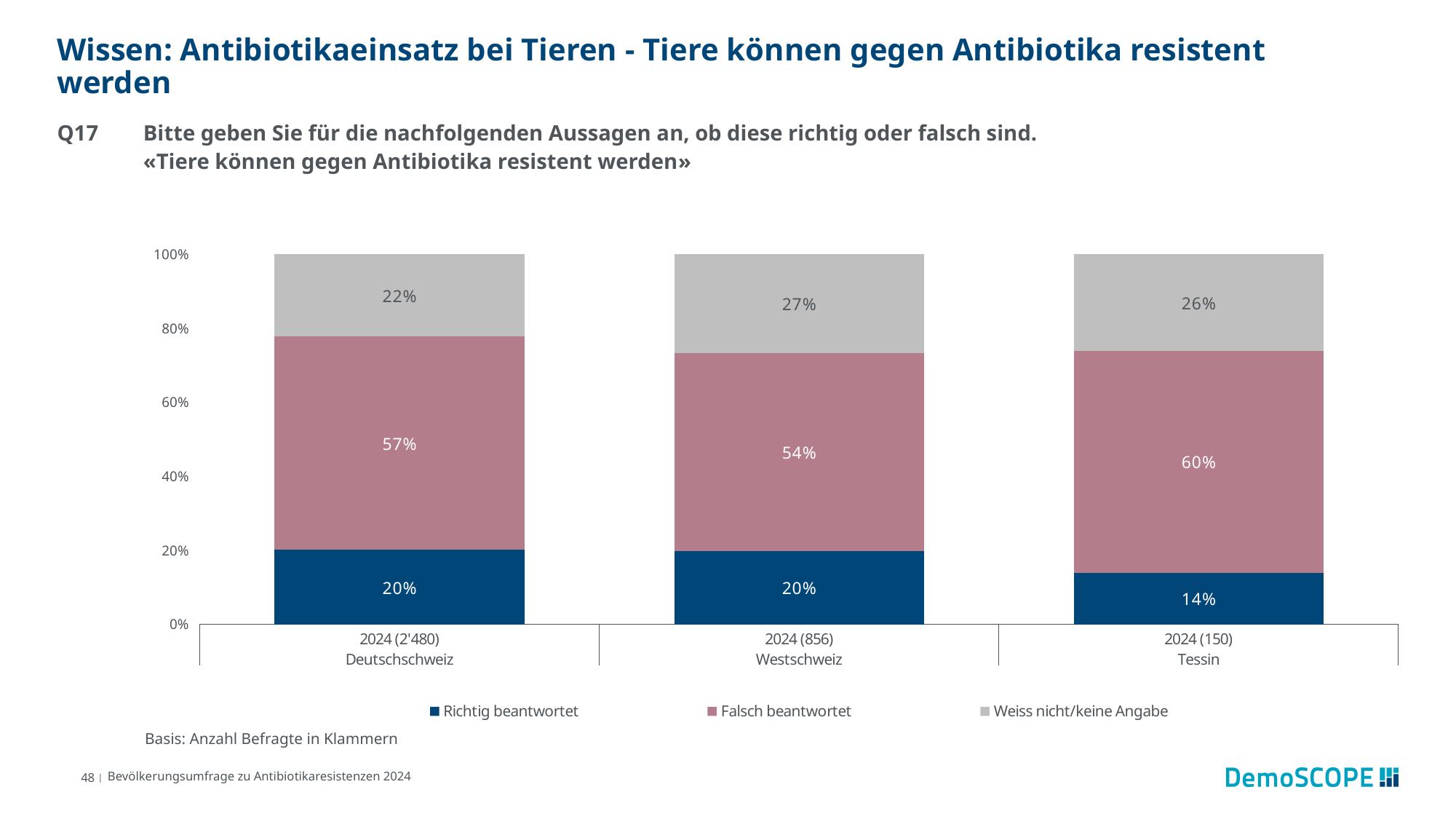
What is the value for "Richtig beantwortet" in Deutschschweiz? 20% What is the value for "Falsch beantwortet" in Tessin? 60% How many series does the legend list? 3 Is the "Weiss nicht/keine Angabe" value larger for Deutschschweiz or Westschweiz? Westschweiz Which region has the lowest value for "Richtig beantwortet"? Tessin Which region has the highest value for "Falsch beantwortet"? Tessin Which colour represents "Richtig beantwortet" in the legend? Dark blue What is the total of the stacked bar for Deutschschweiz? 99% What is the value for "Weiss nicht/keine Angabe" in Westschweiz? 27% What is the difference between the "Falsch beantwortet" values for Tessin and Westschweiz? 6% What kind of chart is shown on the slide? Stacked bar chart How many regions are shown on the x axis? 3